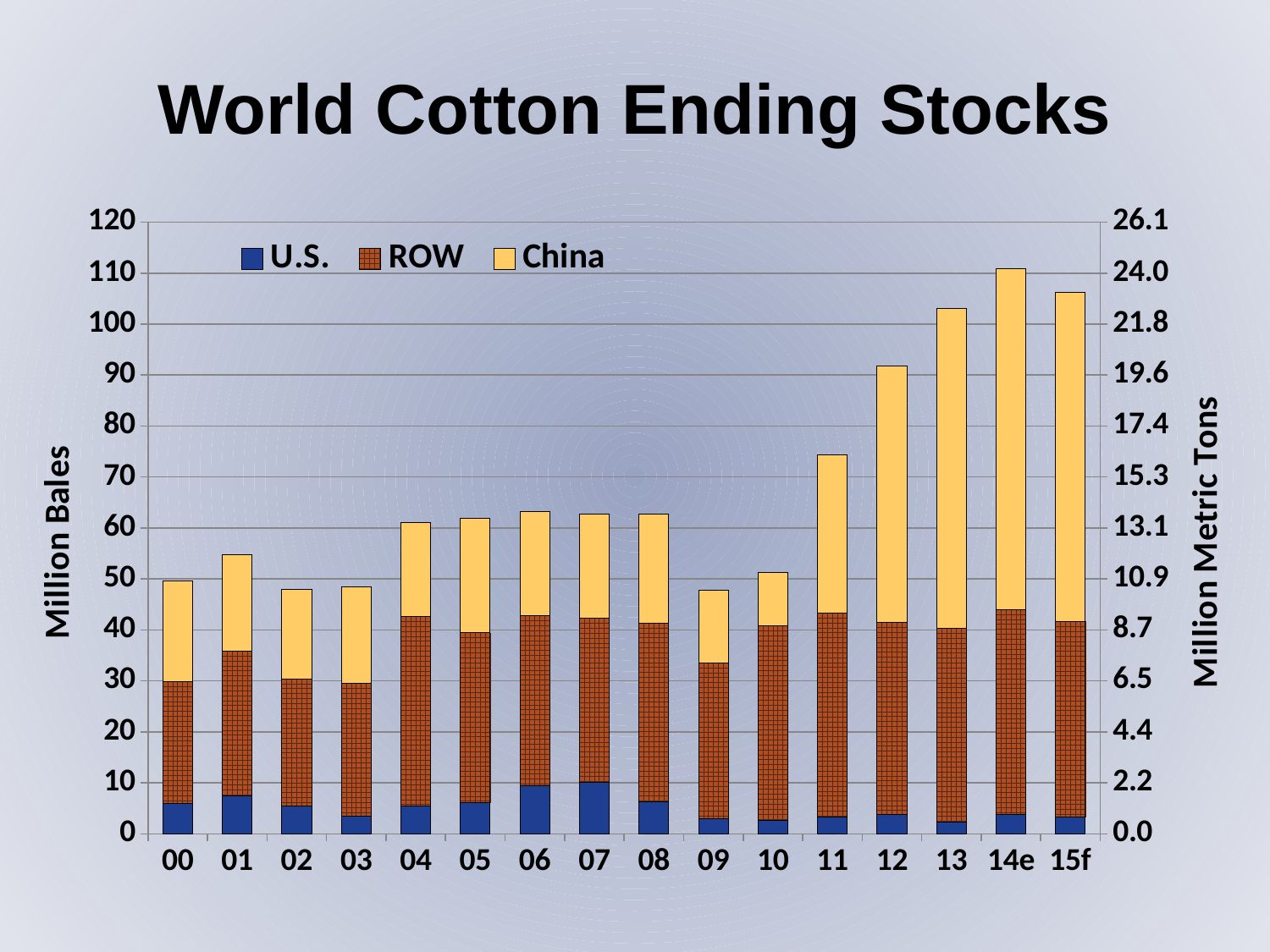
Which year has the highest total ending stocks? 14e Which year has the larger U.S. ending stocks, 07 or 09? 07 What kind of chart is shown on the slide? Stacked bar chart What is the label of the left vertical axis? Million Bales Is the total ending stocks for 11 greater or less than 70 million bales? greater Do total ending stocks rise or fall from 09 to 14e? rise Is the total ending stocks for 00 greater or less than 60 million bales? less What is the title of the chart? World Cotton Ending Stocks How many series does the legend list? 3 Which year has the larger total ending stocks, 10 or 11? 11 Is the total ending stocks for 14e greater or less than 100 million bales? greater How many years (bars) are shown along the x axis? 16